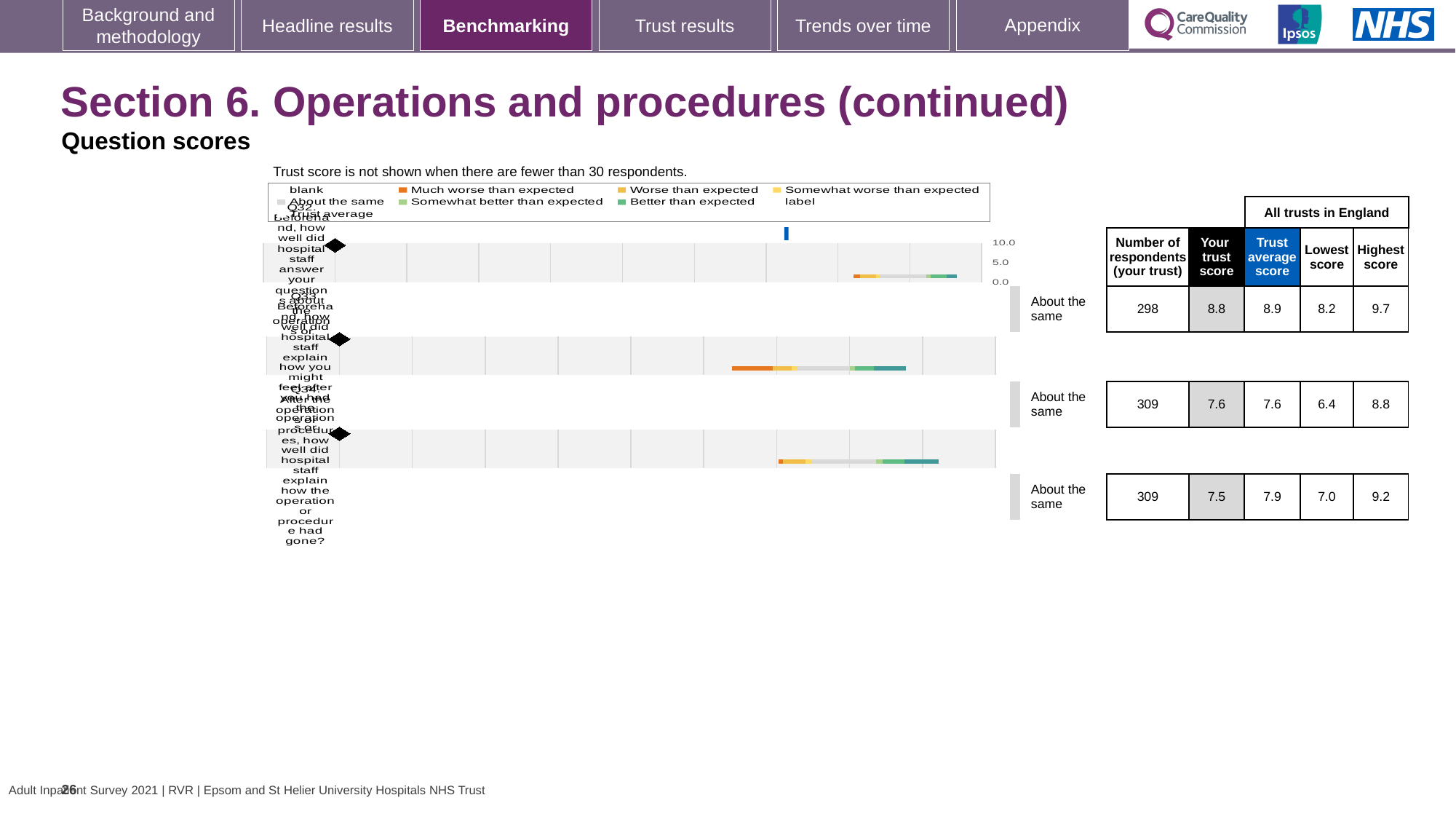
For the first question row, which is larger: 'Your trust score' or the 'Trust average score'? Trust average score In the table beside the chart, what is the 'Lowest score' for the second question row? 6.4 What is the maximum value shown on the chart's score axis? 10.0 How many question rows are plotted in the benchmarking chart? 3 What kind of chart is used to show the question scores on this slide? bar chart In the table beside the chart, what is the 'Highest score' for the third question row? 9.2 In the table beside the chart, what is the 'Trust average score' for the second question row? 7.6 For the third question row, what is the difference between the 'Trust average score' and 'Your trust score'? 0.4 What benchmark category label is shown next to each of the three question rows? About the same In the table beside the chart, what is 'Your trust score' for the first question row? 8.8 In the table beside the chart, what is the number of respondents for the first question row? 298 Which question row has the highest 'Your trust score' in the table? the first row (8.8)